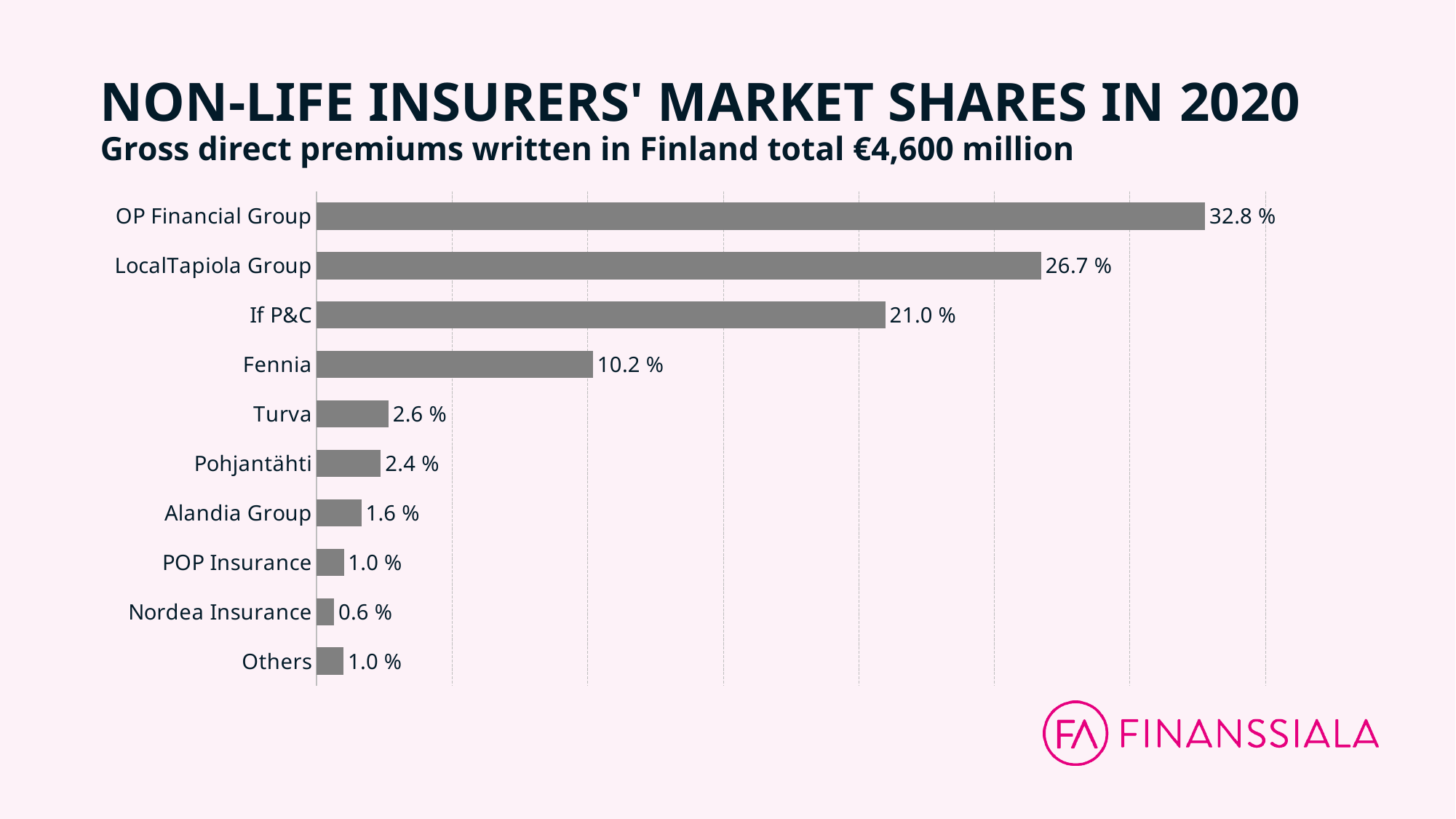
What is the market share of OP Financial Group? 32.8 % What is the market share of Alandia Group? 1.6 % What is the difference in market share between If P&C and Fennia? 10.8 % What is the difference in market share between OP Financial Group and LocalTapiola Group? 6.1 % Which insurer has the lowest market share? Nordea Insurance Which has a larger market share, Turva or Pohjantähti? Turva What is the market share of Fennia? 10.2 % Which has a larger market share, LocalTapiola Group or If P&C? LocalTapiola Group What kind of chart is shown on the slide? Bar chart How many categories are shown in the chart? 10 What is the title of the chart? NON-LIFE INSURERS' MARKET SHARES IN 2020 Which insurer has the highest market share? OP Financial Group